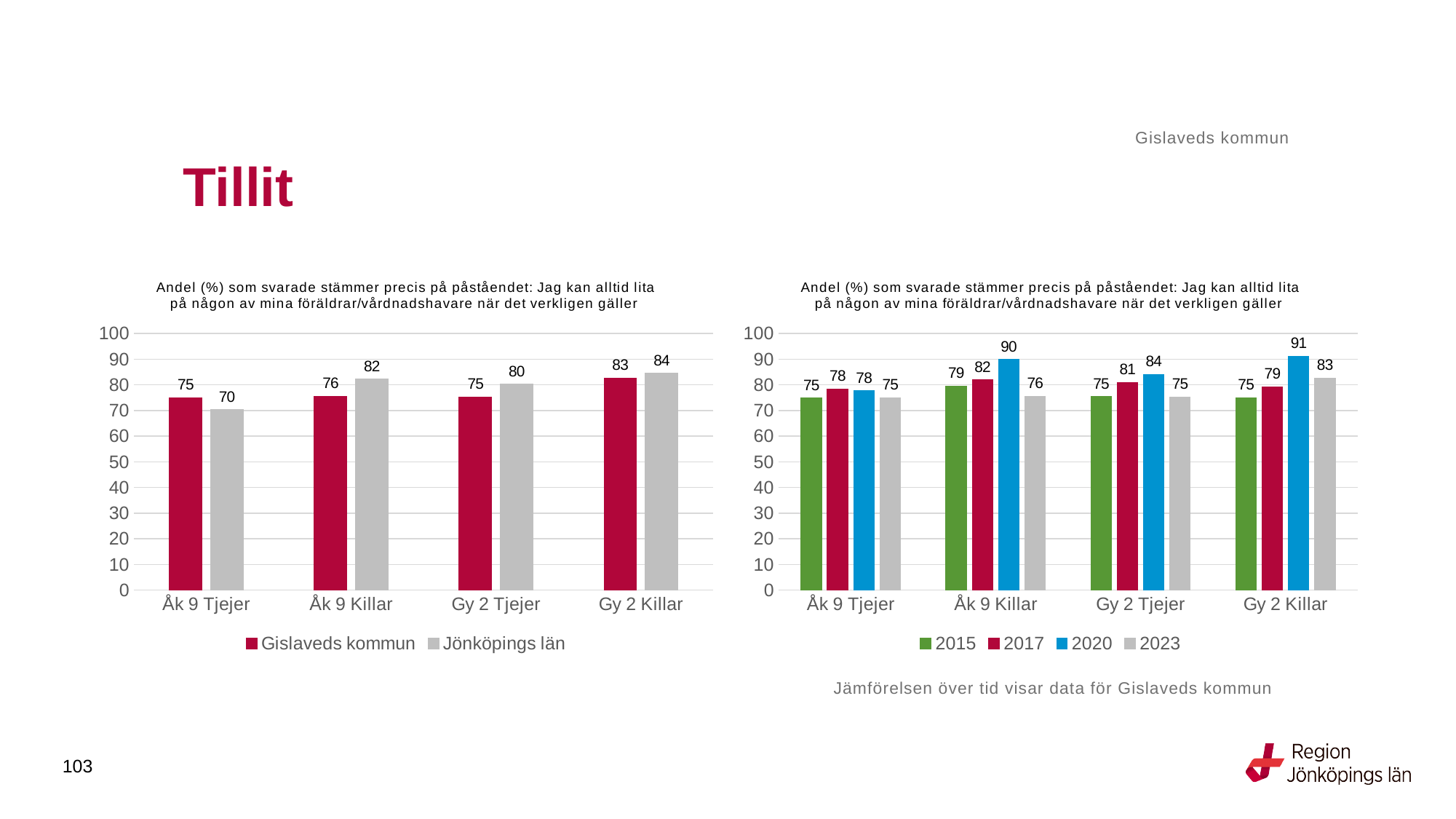
In the right chart, which year has the highest value for Åk 9 Killar? 2020 In the left chart, what is the value for Jönköpings län for Åk 9 Tjejer? 70 In the left chart, what is the difference between Jönköpings län and Gislaveds kommun for Åk 9 Killar? 6 What kind of chart is the left chart? Bar chart In the left chart, which category has the lowest value for Jönköpings län? Åk 9 Tjejer In the left chart, which category has the highest value for Gislaveds kommun? Gy 2 Killar In the left chart, which is larger for Gy 2 Tjejer: Gislaveds kommun or Jönköpings län? Jönköpings län In the right chart, what is the difference between the 2020 and 2015 values for Gy 2 Killar? 16 In the right chart, what is the value for 2023 for Åk 9 Killar? 76 In the left chart, what is the value for Gislaveds kommun for Åk 9 Killar? 76 How many series does the legend of the right chart list? 4 In the right chart, what is the value for 2020 for Gy 2 Killar? 91